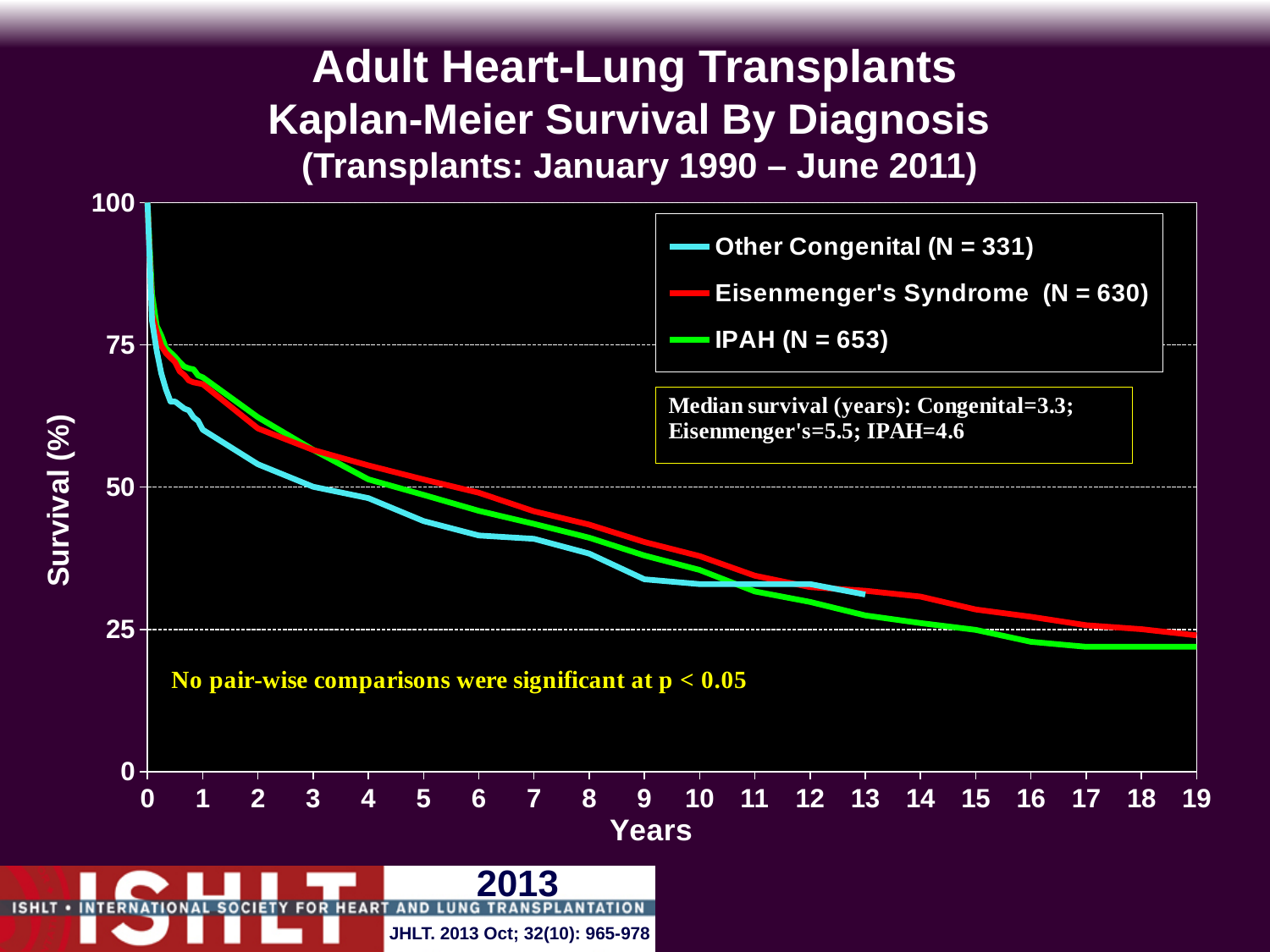
What is the median survival in years for the IPAH group? 4.6 Which diagnosis group has the lowest median survival? Other Congenital According to the legend, what is the N for the IPAH group? 653 Is the survival for IPAH at 10 years greater or less than 50? less Do the survival curves rise or fall as years increase? fall What is the difference in median survival (years) between Eisenmenger's Syndrome and Congenital? 2.2 Which diagnosis group has the highest median survival? Eisenmenger's Syndrome What is the median survival in years for the Eisenmenger's Syndrome group? 5.5 Is the survival for Other Congenital at 1 year greater or less than 75? less What kind of chart is shown on the slide? line chart How many series does the legend list? 3 At 5 years, which curve shows higher survival, Other Congenital or Eisenmenger's Syndrome? Eisenmenger's Syndrome